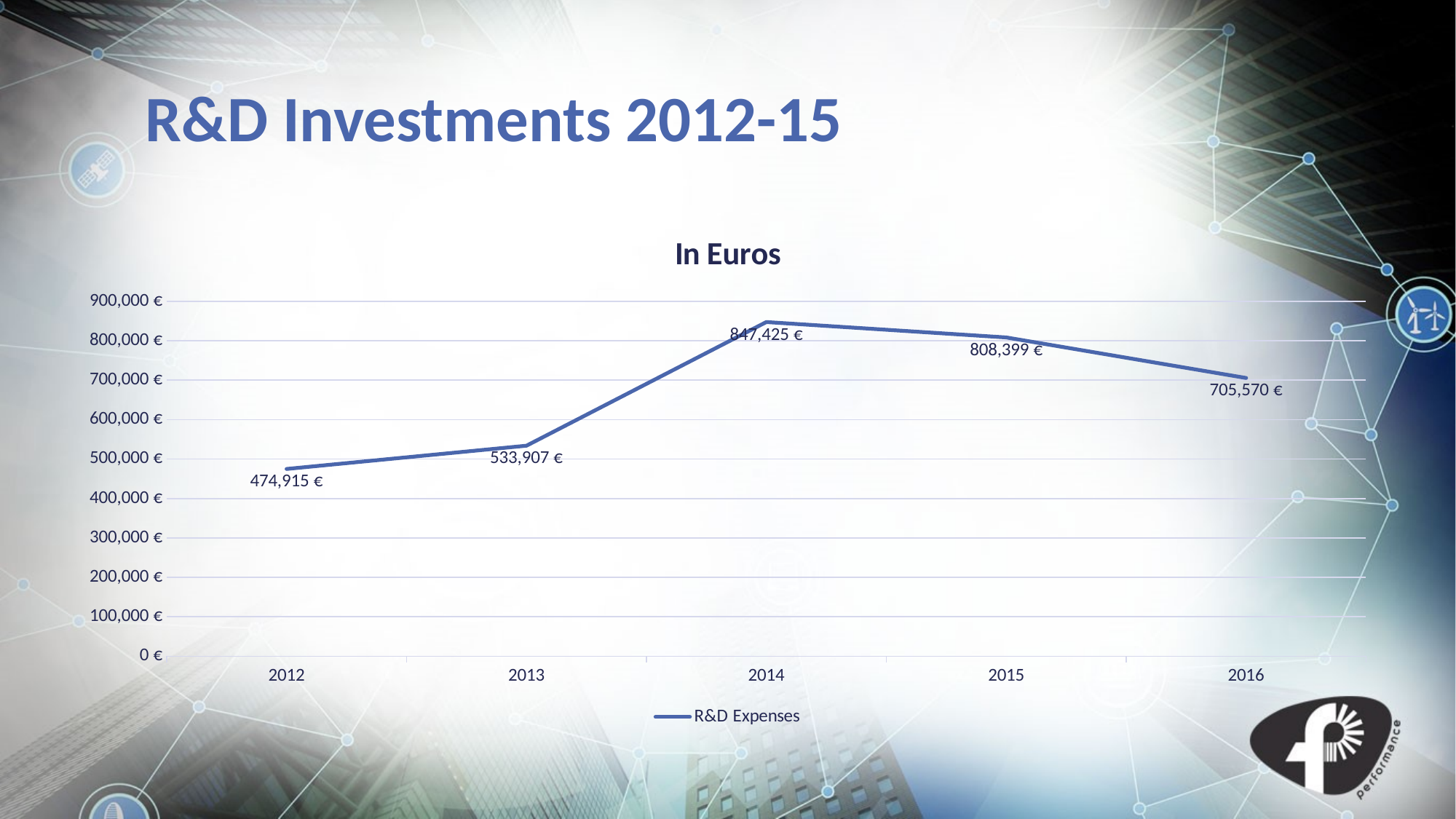
What is the difference between R&D Expenses in 2015 and 2016? 102,829 € What is the difference between R&D Expenses in 2014 and 2013? 313,518 € What is the value of R&D Expenses for 2014? 847,425 € What is the value of R&D Expenses for 2016? 705,570 € How many years are plotted on the x axis? 5 Which year has the highest R&D Expenses? 2014 What type of chart is shown on the slide? line chart Which year has the lowest R&D Expenses? 2012 Do R&D Expenses rise or fall from 2014 to 2016? fall Which year has larger R&D Expenses, 2013 or 2015? 2015 What is the value of R&D Expenses for 2012? 474,915 € What is the title of the chart? In Euros